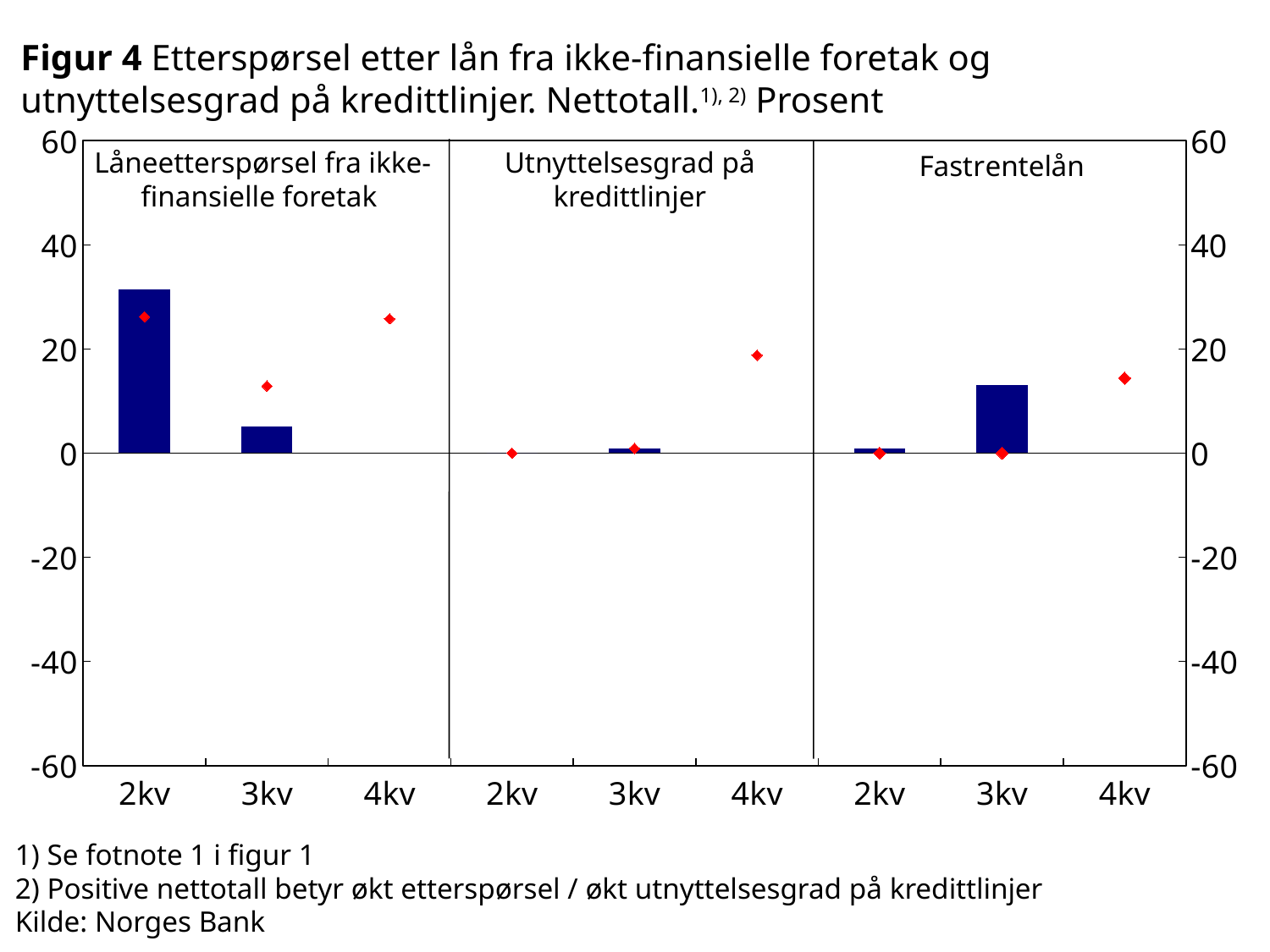
In the panel 'Utnyttelsesgrad på kredittlinjer', is the red marker for 4kv greater or less than 10? greater What is the highest value shown on the y axis? 60 In the panel 'Låneetterspørsel fra ikke-finansielle foretak', which quarter has the taller bar, 2kv or 3kv? 2kv In the panel 'Fastrentelån', which quarter has the taller bar, 2kv or 3kv? 3kv In the panel 'Låneetterspørsel fra ikke-finansielle foretak', is the bar for 2kv greater or less than 20? greater In the panel 'Låneetterspørsel fra ikke-finansielle foretak', is the bar for 2kv greater or less than 40? less What kind of chart is shown on the slide? combination bar and line chart (bars with red diamond markers) How many quarters are labelled on the x axis of each panel? 3 Across all three panels, which panel contains the tallest bar? Låneetterspørsel fra ikke-finansielle foretak How many panels (sections) does the chart have? 3